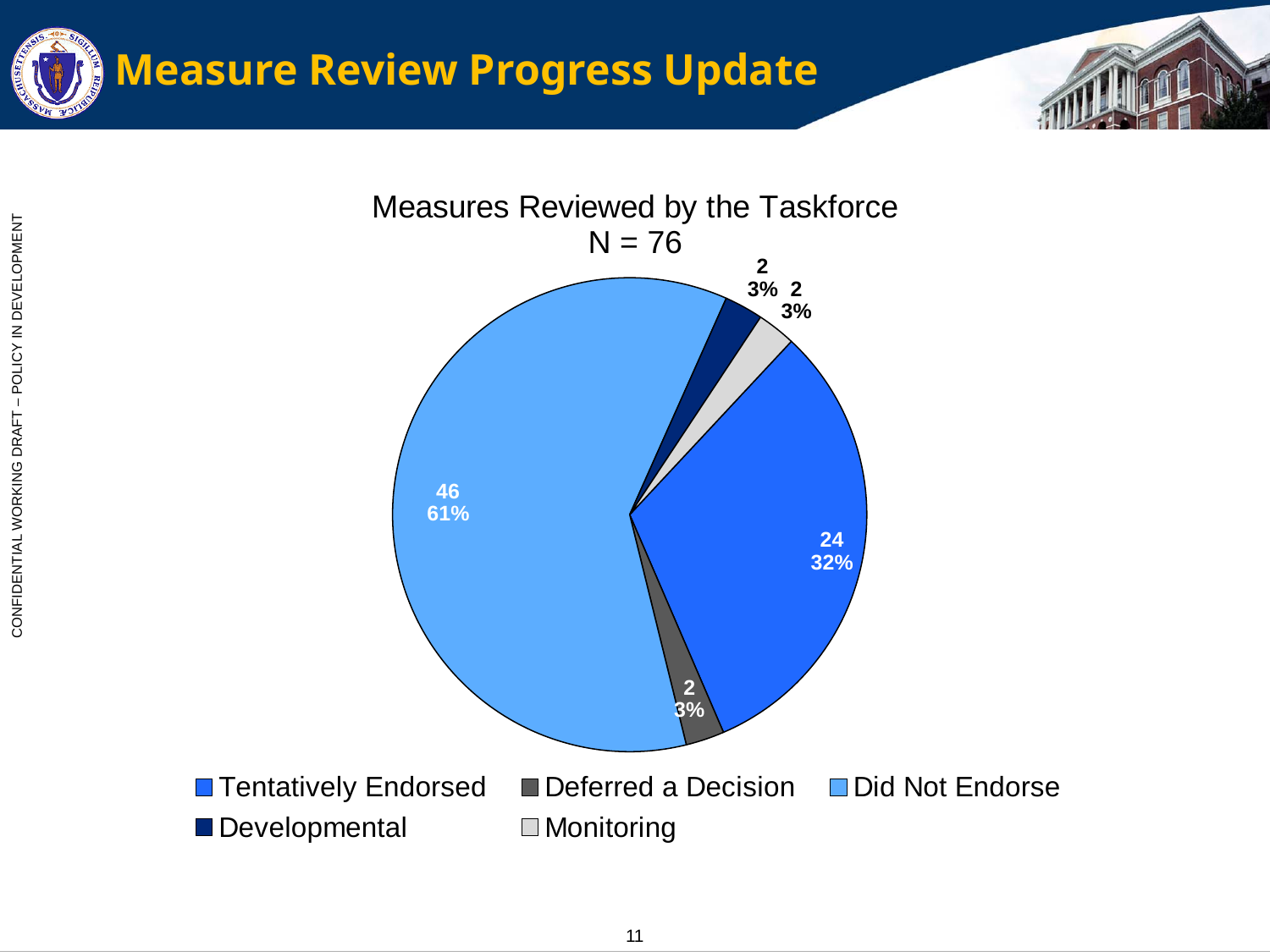
Which category has the largest slice of the pie? Did Not Endorse What percentage of measures fall in the Monitoring category? 3% How many measures were in the Did Not Endorse category? 46 What is the difference between the number of Did Not Endorse measures and Tentatively Endorsed measures? 22 What is the total number of measures (N) stated in the chart title? 76 How many measures had a Deferred a Decision outcome? 2 How many categories does the pie chart show? 5 What percentage of measures were Tentatively Endorsed? 32% What type of chart is shown on the slide? pie chart How many measures were Tentatively Endorsed? 24 What share of the pie does Did Not Endorse represent? 61% Which is larger, the Tentatively Endorsed slice or the Developmental slice? Tentatively Endorsed